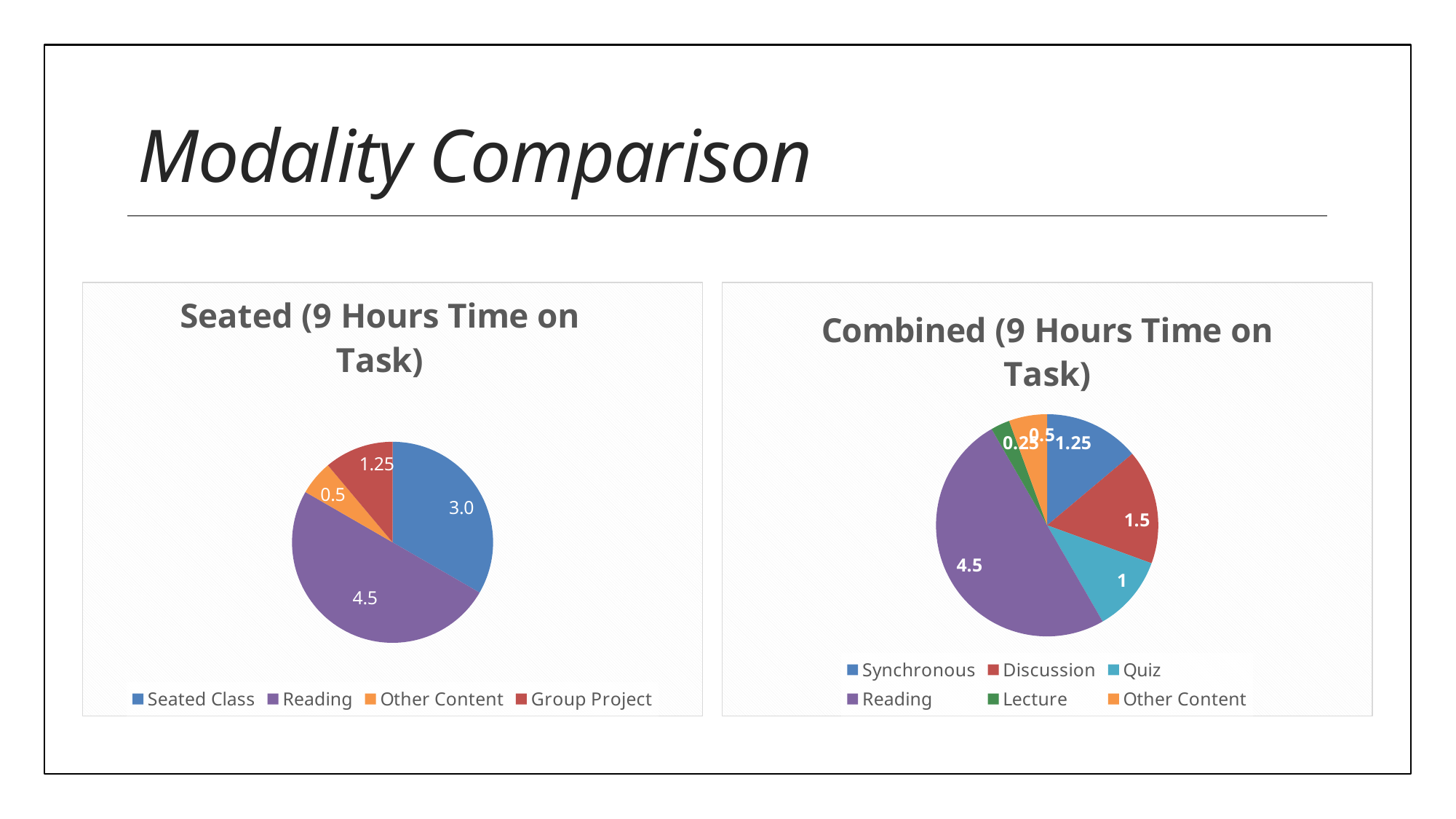
What type of chart is the Combined (9 Hours Time on Task) chart? Pie chart In the Combined (9 Hours Time on Task) chart, which category has the smallest slice? Lecture In the Seated (9 Hours Time on Task) chart, what is the value for Group Project? 1.25 In the Combined (9 Hours Time on Task) chart, what is the value for Lecture? 0.25 In the Seated (9 Hours Time on Task) chart, what is the value for Reading? 4.5 In the Seated (9 Hours Time on Task) chart, what is the difference between the Seated Class value and the Other Content value? 2.5 How many categories does the Seated (9 Hours Time on Task) chart show? 4 In the Combined (9 Hours Time on Task) chart, what share of the total does Reading represent? 50% In the Combined (9 Hours Time on Task) chart, which is larger, Discussion or Quiz? Discussion How many categories does the Combined (9 Hours Time on Task) chart show? 6 In the Combined (9 Hours Time on Task) chart, what is the value for Discussion? 1.5 In the Seated (9 Hours Time on Task) chart, which category has the largest slice? Reading